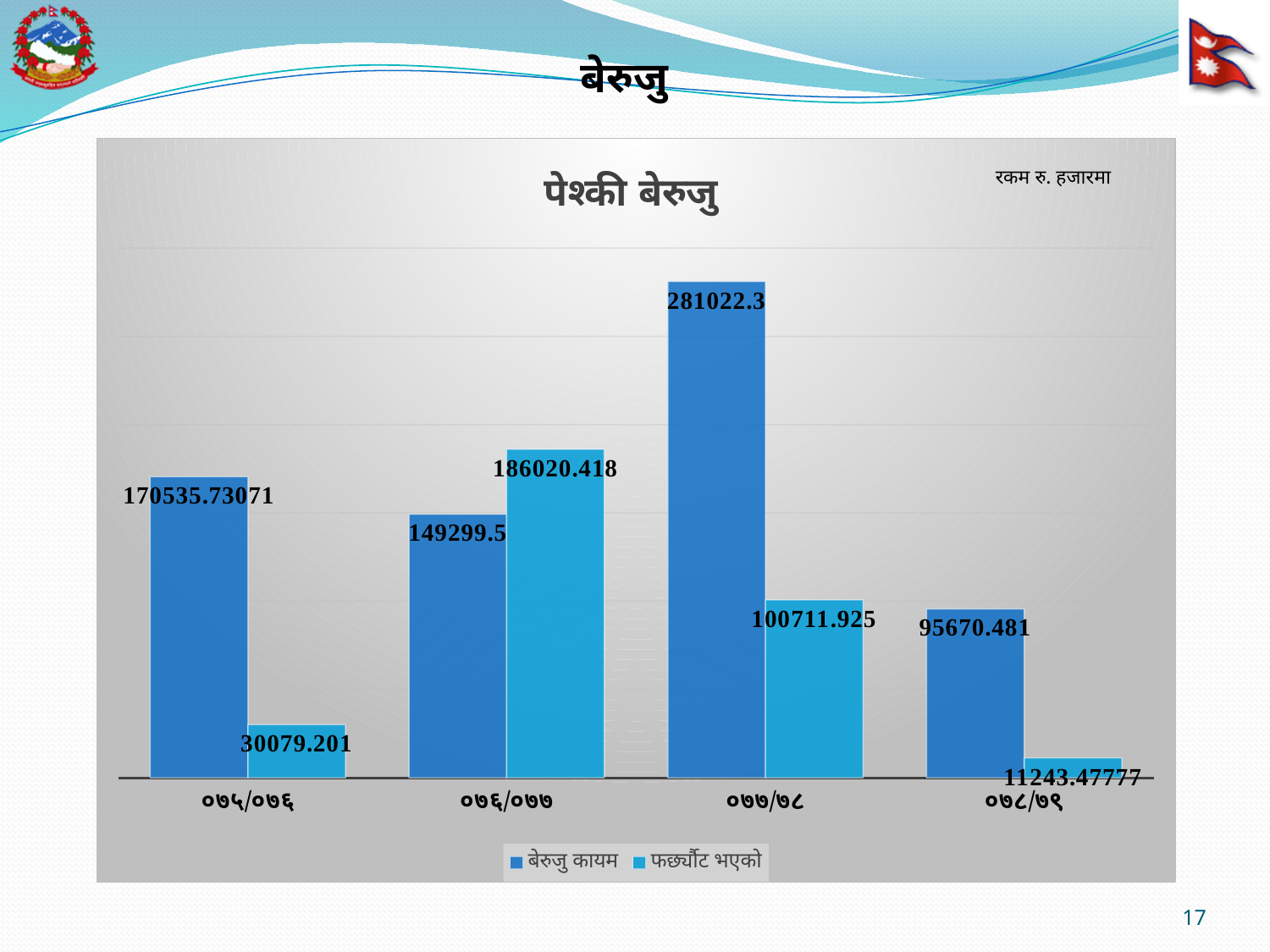
How many fiscal years are shown on the x axis? 4 How many series does the legend list? 2 What is the difference between बेरुजु कायम and फर्छ्यौट भएको for ०७७/७८? 180310.375 Which fiscal year has the lowest फर्छ्यौट भएको value? ०७८/७९ What is the value of फर्छ्यौट भएको for ०७५/०७६? 30079.201 What kind of chart is shown on the slide? Bar chart What is the difference between फर्छ्यौट भएको and बेरुजु कायम for ०७६/०७७? 36720.918 For ०७६/०७७, which is larger: बेरुजु कायम or फर्छ्यौट भएको? फर्छ्यौट भएको What is the value of बेरुजु कायम for ०७८/७९? 95670.481 What is the value of फर्छ्यौट भएको for ०७६/०७७? 186020.418 What is the value of बेरुजु कायम for ०७७/७८? 281022.3 Which fiscal year has the highest बेरुजु कायम value? ०७७/७८